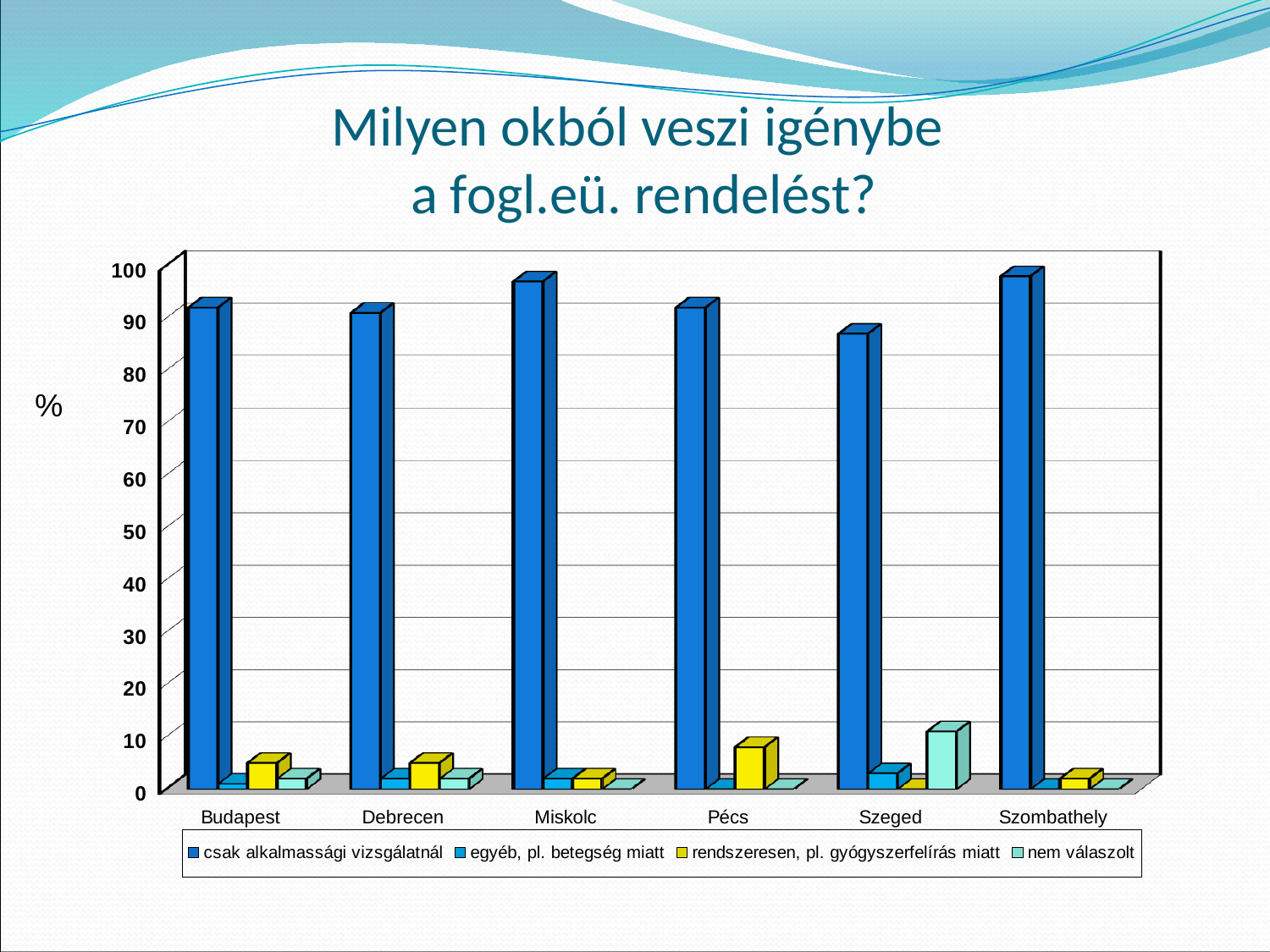
What kind of chart is shown on the slide? bar chart Which is larger: the 'csak alkalmassági vizsgálatnál' value for Miskolc or for Szeged? Miskolc What unit is shown on the y axis of the chart? % What is the title of the chart? Milyen okból veszi igénybe a fogl.eü. rendelést? Is the value for 'csak alkalmassági vizsgálatnál' in Miskolc greater or less than 90? greater Which city has the lowest value for 'csak alkalmassági vizsgálatnál'? Szeged Is the value for 'rendszeresen, pl. gyógyszerfelírás miatt' in Pécs greater or less than 10? less How many cities are shown on the x axis of the chart? 6 Which city has the highest value for 'nem válaszolt'? Szeged Is the value for 'csak alkalmassági vizsgálatnál' in Szeged greater or less than 90? less Which city has the highest value for 'rendszeresen, pl. gyógyszerfelírás miatt'? Pécs How many series does the legend list? 4